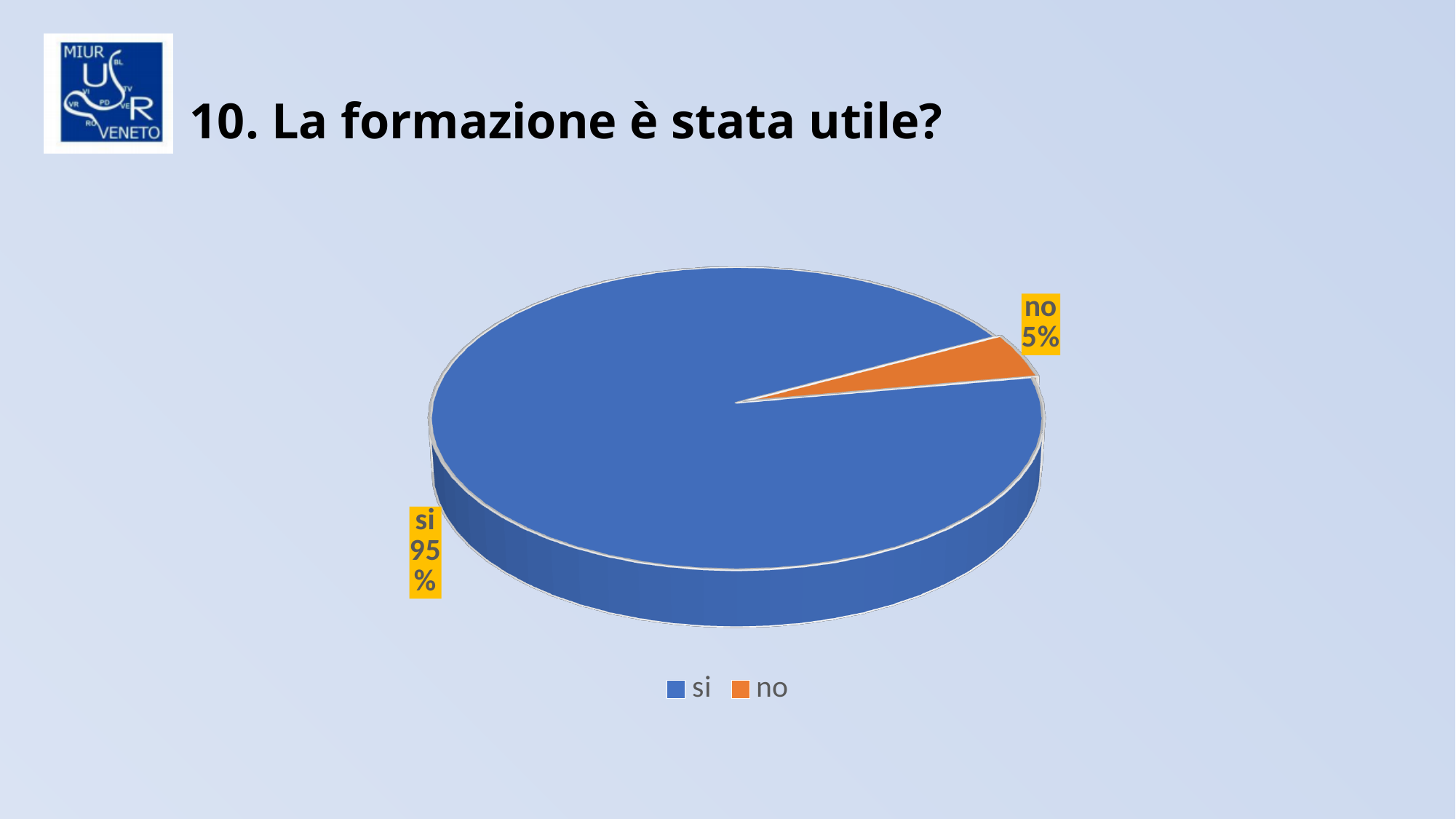
How many slices does the pie chart have? 2 What share of the pie does the "no" slice represent? 5% What is the title of the slide above the chart? 10. La formazione è stata utile? Which category has the largest slice of the pie? si What is the difference in percentage points between the "si" and "no" slices? 90 What colour is the "no" slice in the pie chart? orange How many entries does the legend list? 2 What share of the pie does the "si" slice represent? 95% Which category has the smallest slice of the pie? no What kind of chart is shown on the slide? pie chart Which slice is larger, "si" or "no"? si